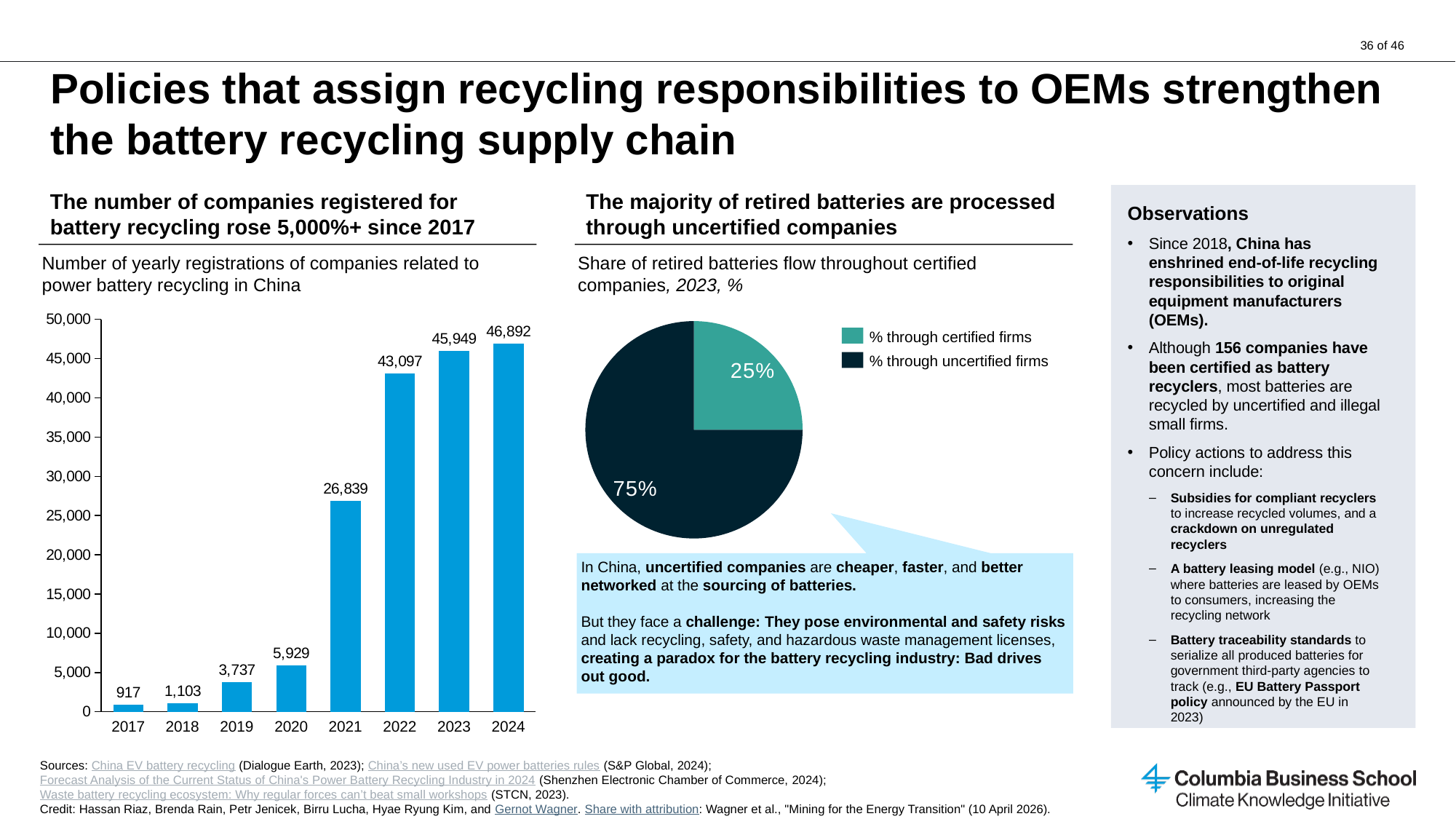
In the bar chart on the left, which is larger: the value for 2020 or the value for 2019? 2020 In the pie chart, what share of retired batteries flows through uncertified firms? 75% In the bar chart on the left, which year has the highest number of registrations? 2024 In the pie chart, what share of retired batteries flows through certified firms? 25% In the bar chart on the left, how many years are shown on the x axis? 8 In the bar chart on the left, which year has the lowest number of registrations? 2017 In the bar chart on the left, what is the number of yearly registrations in 2021? 26,839 In the bar chart on the left, do the values rise or fall from 2017 to 2024? Rise What kind of chart is the chart on the left? Bar chart How many entries does the legend of the pie chart list? 2 In the bar chart on the left, what is the difference between the 2024 and 2023 values? 943 In the bar chart on the left, what is the number of yearly registrations in 2017? 917